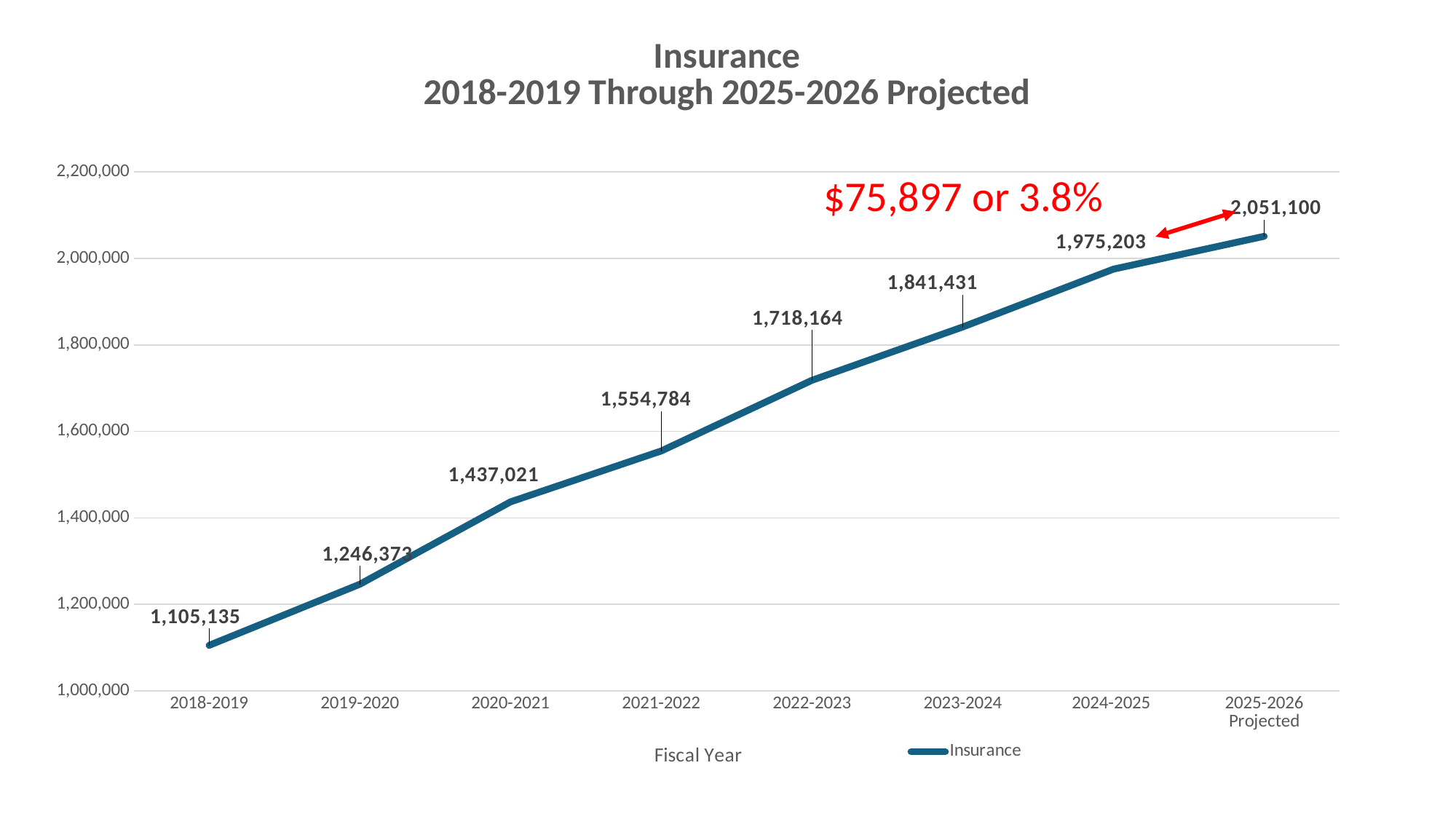
Is the Insurance value for 2022-2023 greater or less than 1,600,000? greater Do the Insurance values rise or fall from 2018-2019 to 2025-2026 Projected? rise What is the Insurance value for 2023-2024? 1,841,431 What kind of chart is shown on the slide? line chart What is the Insurance value for 2018-2019? 1,105,135 Which is larger, the Insurance value for 2020-2021 or for 2019-2020? 2020-2021 What is the projected Insurance value for 2025-2026? 2,051,100 How many fiscal years are plotted on the chart? 8 What is the Insurance value for 2021-2022? 1,554,784 Which fiscal year has the highest Insurance value? 2025-2026 Projected Which fiscal year has the lowest Insurance value? 2018-2019 What is the difference between the Insurance values for 2025-2026 Projected and 2024-2025? 75,897